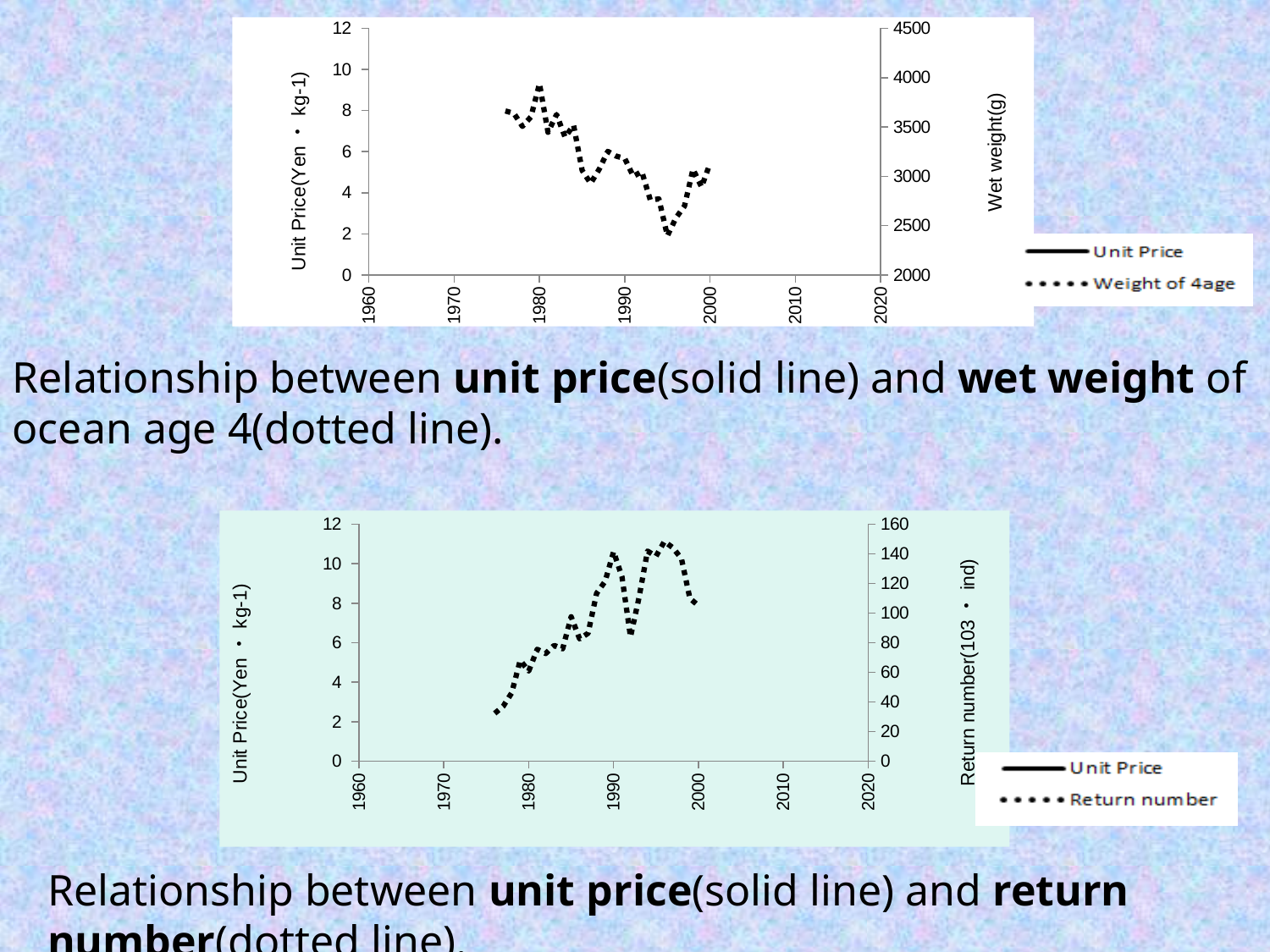
In the top chart, which legend entry is drawn with a dotted line? Weight of 4age In the bottom chart, is the Return number value around 1996 greater or less than 120 on the right axis? greater In the bottom chart, does the Return number line overall rise or fall between 1976 and 1996? rise In the top chart, how many series does the legend list? 2 In the top chart, what kind of chart is shown? line chart In the top chart, what is the label of the right-hand vertical axis? Wet weight(g) In the bottom chart, is the Return number value around 1976 greater or less than 60 on the right axis? less In the top chart, is the Weight of 4age value around 1995 greater or less than 3000 on the right axis? less In the bottom chart, how many series does the legend list? 2 In the bottom chart, what is the highest value shown on the right-hand vertical axis? 160 In the top chart, does the Weight of 4age line overall rise or fall between 1980 and 1995? fall